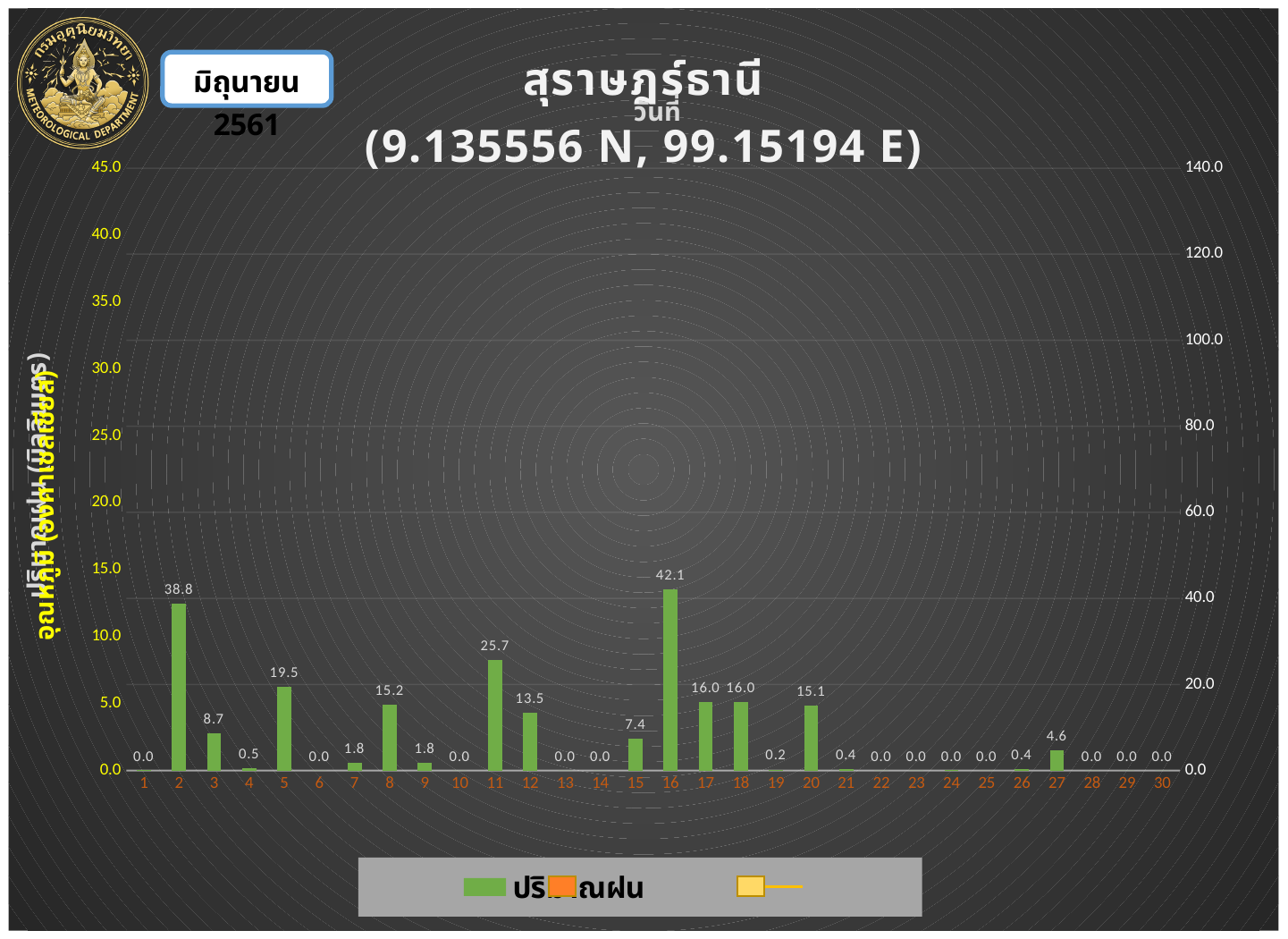
Which is larger, the rainfall value for day 8 or for day 12? day 8 How many days are shown on the x axis of the chart? 30 What is the difference between the rainfall values for day 5 and day 3? 10.8 What is the rainfall value shown for day 27? 4.6 What is the rainfall value shown for day 2? 38.8 What is the rainfall value shown for day 11? 25.7 Which is larger, the rainfall value for day 11 or for day 5? day 11 What is the rainfall value shown for day 16? 42.1 Which day has the highest rainfall value on the chart? 16 What kind of chart is shown on the slide? bar chart What is the difference between the rainfall values for day 16 and day 2? 3.3 What coordinates are given in the chart title? 9.135556 N, 99.15194 E